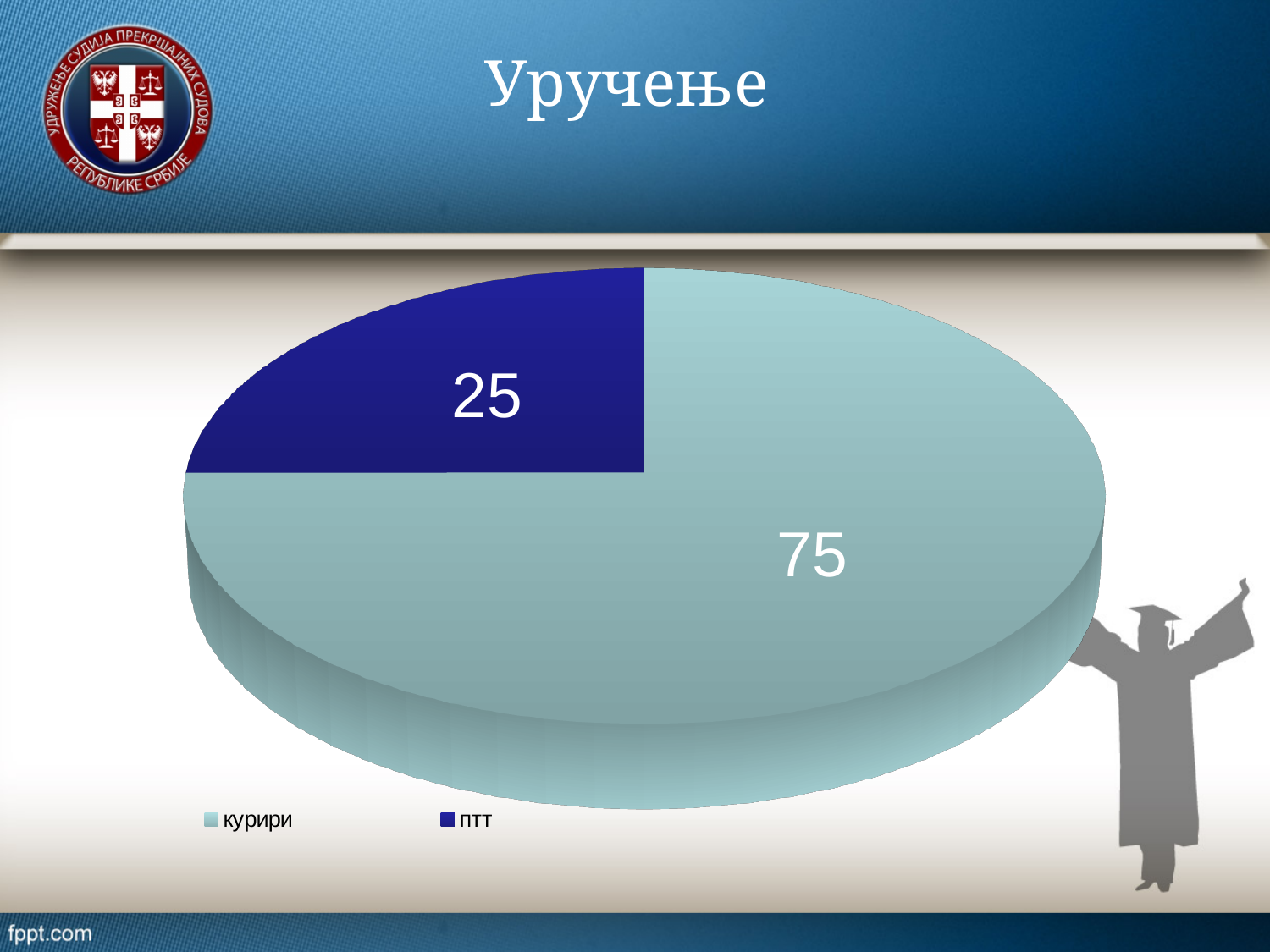
How many slices does the pie chart have? 2 What is the title of the slide? Уручење What share of the pie does птт represent? 25% What colour is the slice for птт? dark blue Which category has the smallest slice? птт What is the value for птт? 25 What is the value for курири? 75 Which category has the largest slice? курири How many entries does the legend list? 2 Which is larger, the value for курири or the value for птт? курири What is the difference between the values for курири and птт? 50 What type of chart is shown on the slide? pie chart